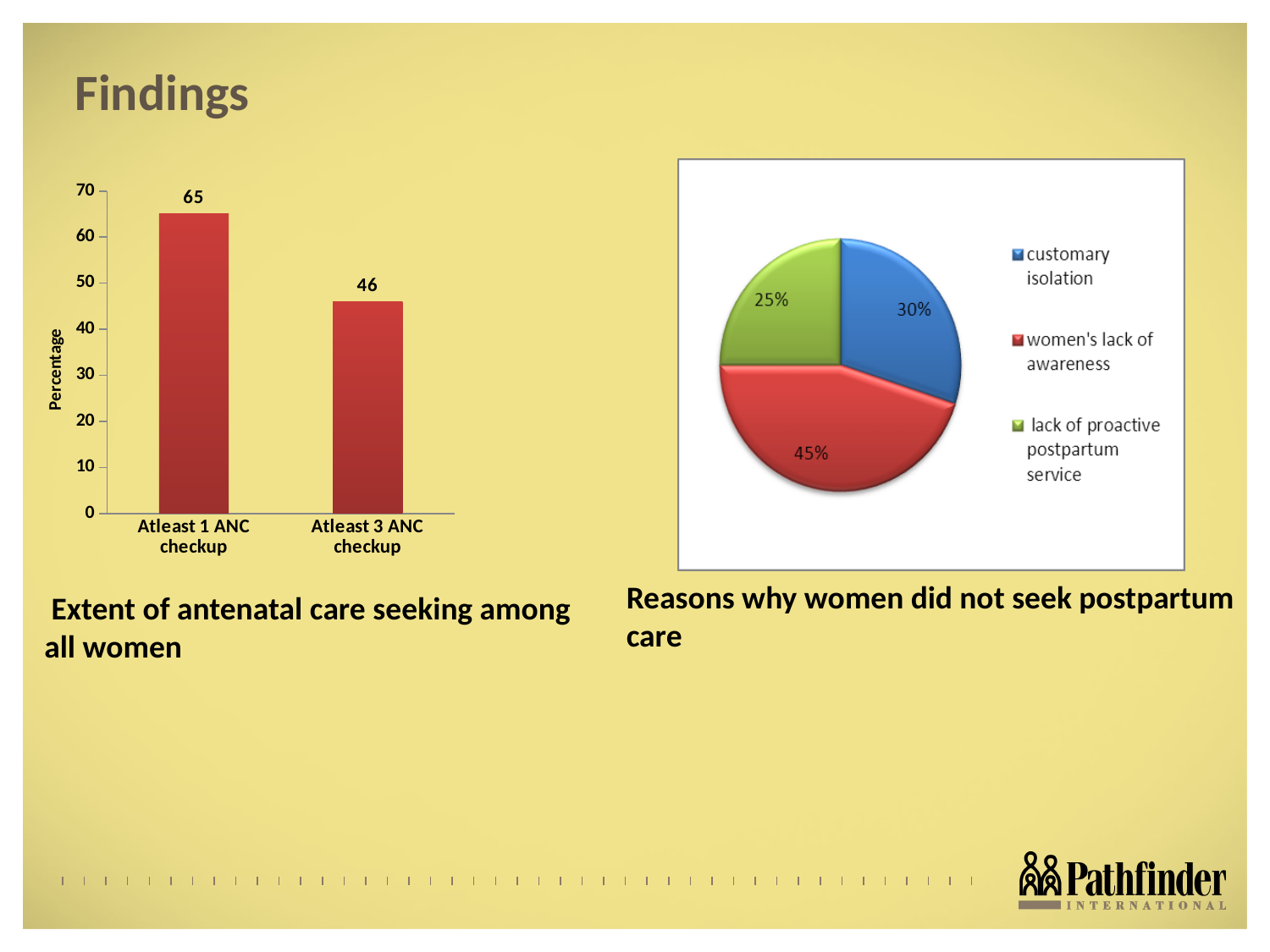
What kind of chart is the chart on the left of the slide? Bar chart In the pie chart on the right (Reasons why women did not seek postpartum care), what share is customary isolation? 30% In the pie chart on the right, which reason has the smallest share? lack of proactive postpartum service In the bar chart on the left, is the value for Atleast 3 ANC checkup greater or less than 50? less How many entries does the legend of the pie chart on the right list? 3 In the bar chart on the left, which category has the higher value? Atleast 1 ANC checkup What is the axis title of the vertical axis in the bar chart on the left? Percentage In the bar chart on the left (Extent of antenatal care seeking among all women), what is the value for Atleast 3 ANC checkup? 46 In the pie chart on the right (Reasons why women did not seek postpartum care), what share is women's lack of awareness? 45% In the bar chart on the left, what is the difference between the values for Atleast 1 ANC checkup and Atleast 3 ANC checkup? 19 In the bar chart on the left (Extent of antenatal care seeking among all women), what is the value for Atleast 1 ANC checkup? 65 How many categories are shown in the bar chart on the left? 2